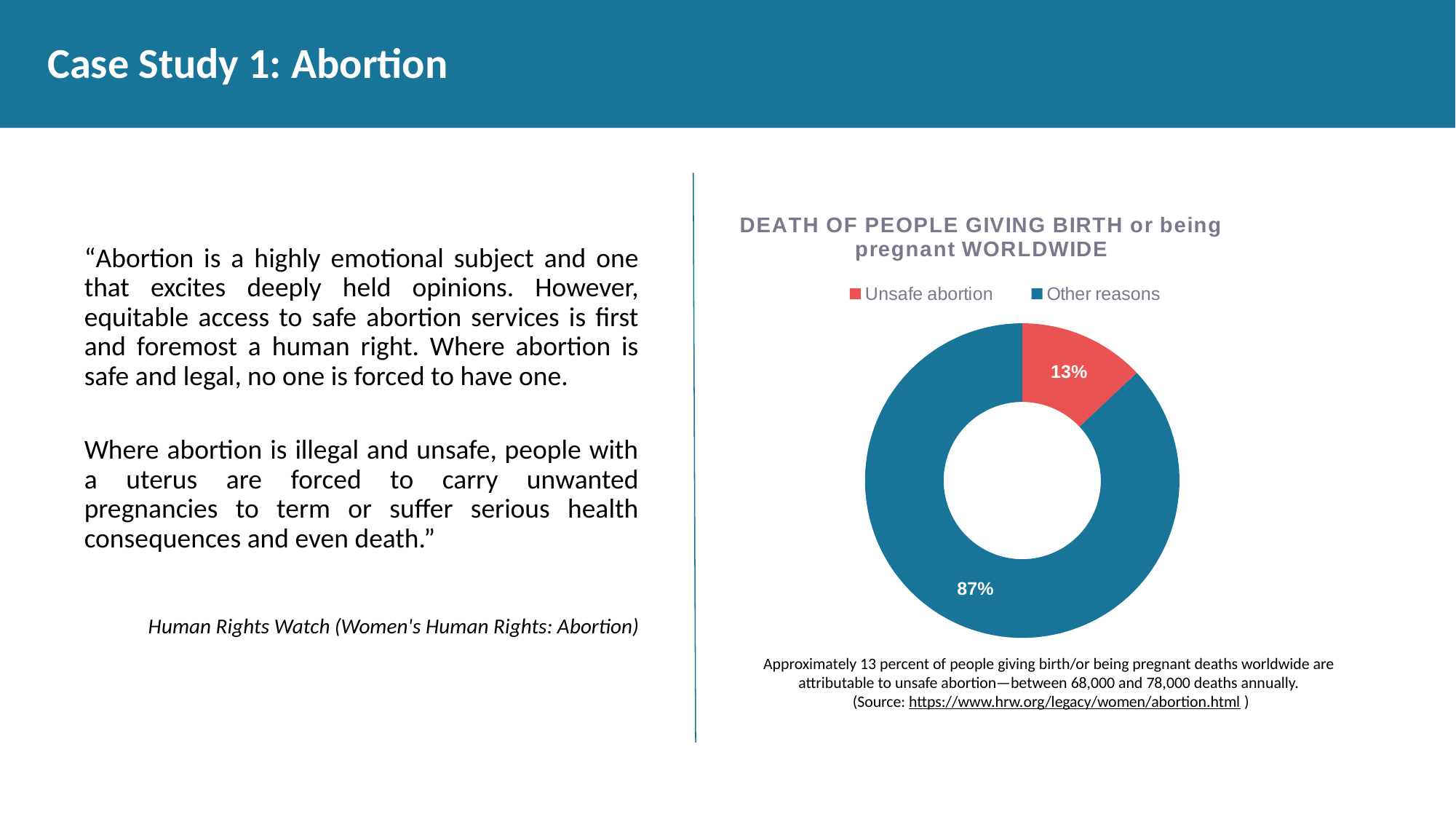
What colour is the 'Unsafe abortion' slice in the chart? Red What is the title of the chart? DEATH OF PEOPLE GIVING BIRTH or being pregnant WORLDWIDE What is the difference in percentage points between the 'Other reasons' and 'Unsafe abortion' slices? 74 percentage points Which category accounts for the smallest share of the chart? Unsafe abortion What is the total of the two slices shown in the chart? 100% How many entries does the chart legend list? 2 What share of deaths of people giving birth or being pregnant worldwide is attributed to unsafe abortion? 13% What kind of chart is shown on the slide? Doughnut (pie) chart Which category accounts for the largest share of the chart? Other reasons What share of deaths of people giving birth or being pregnant worldwide is attributed to other reasons? 87% How many categories does the chart show? 2 Which is larger: the share for 'Unsafe abortion' or the share for 'Other reasons'? Other reasons